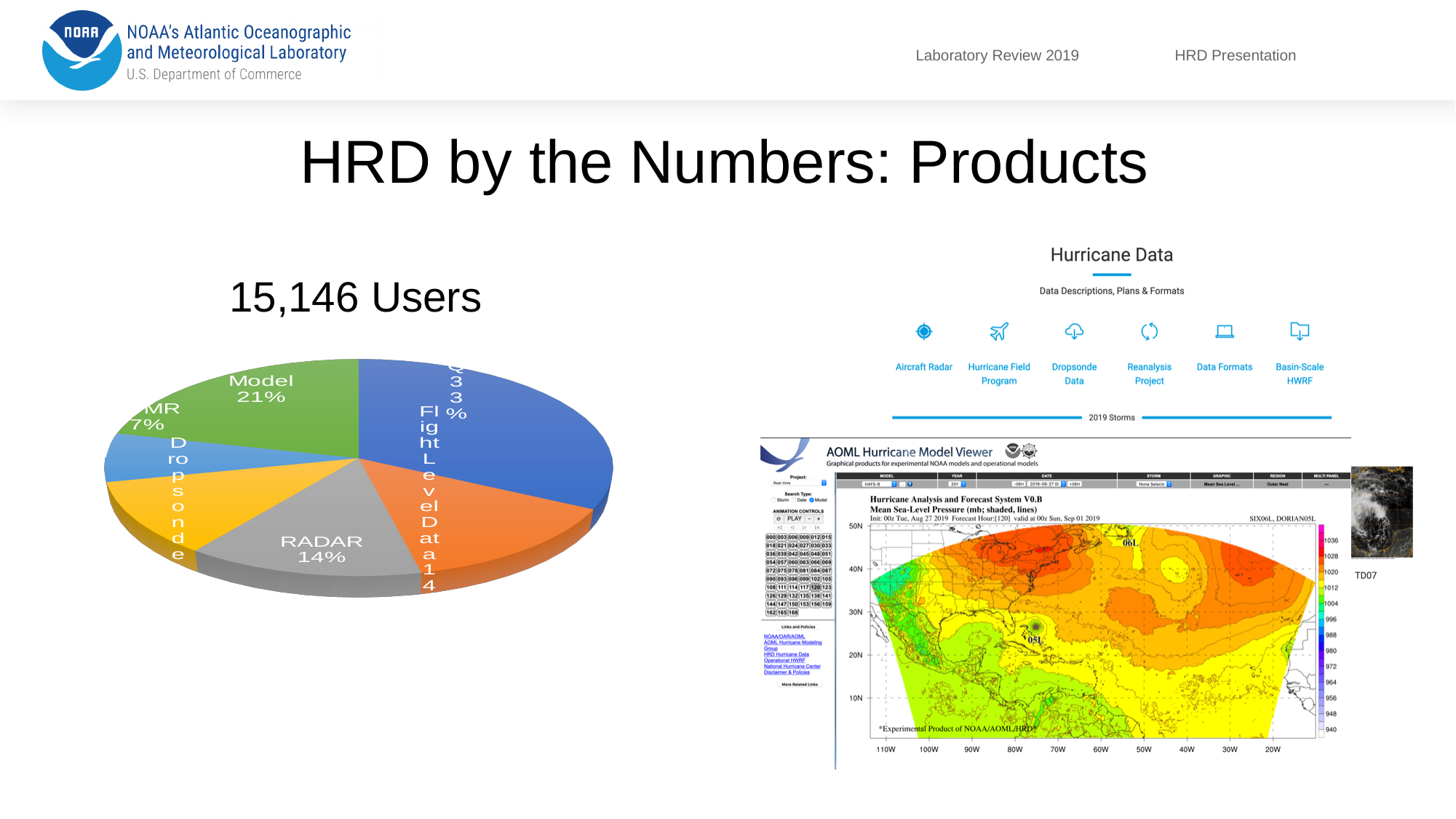
What percentage of the pie chart is labelled RADAR? 14% What percentage is printed on the largest (blue) slice of the pie chart? 33% Which slice is larger in the pie chart, Model or the slice labelled 7%? Model What percentage of the pie chart is labelled Model? 21% What colour is the Model slice in the pie chart? green Which slice is larger in the pie chart, Model or RADAR? Model How many slices does the pie chart have? 6 What number of users is stated above the pie chart? 15,146 Users By how many percentage points does the Model slice exceed the RADAR slice? 7 What kind of chart is shown on the left of the slide? pie chart